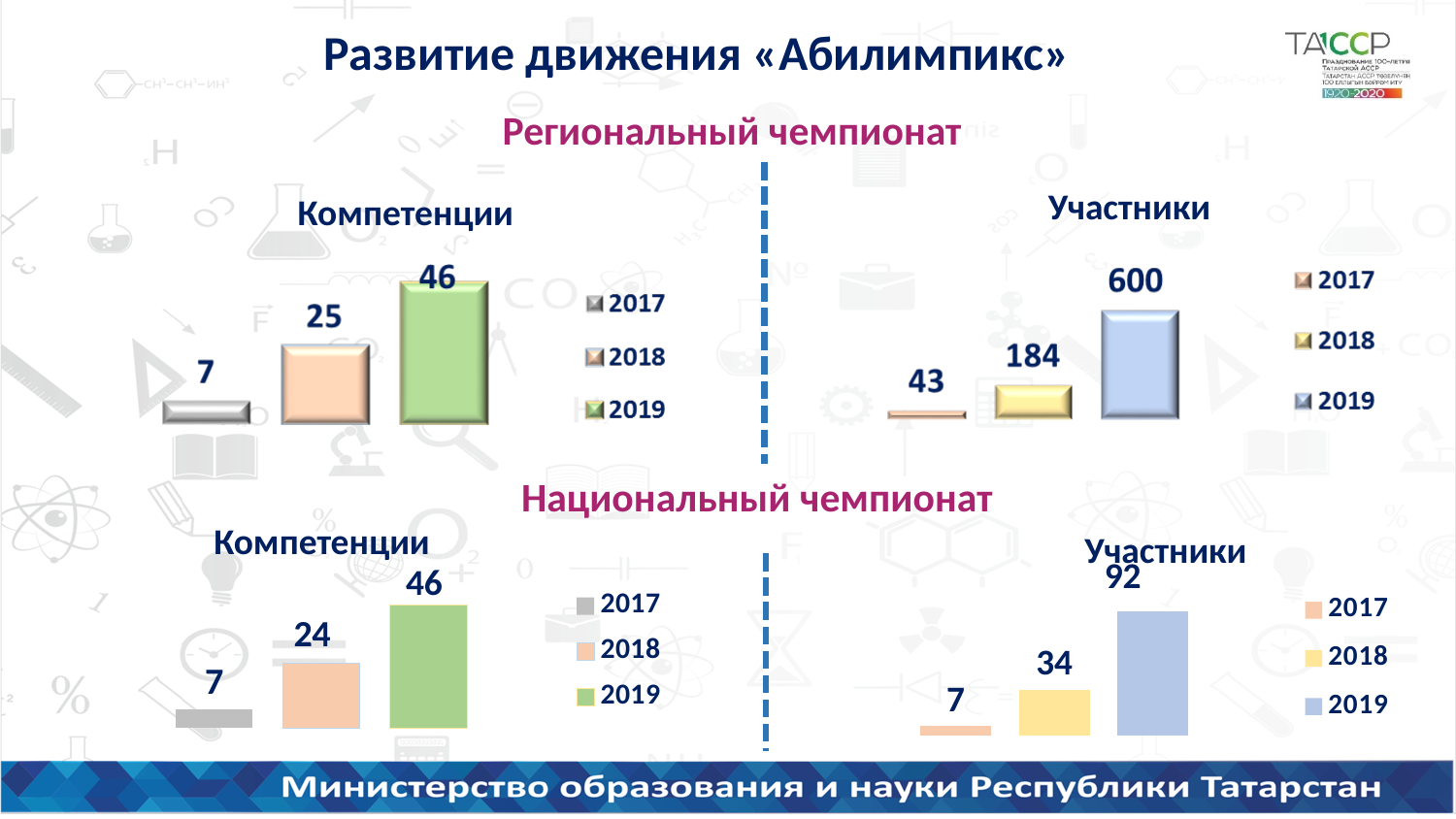
In the 'Компетенции' chart under 'Региональный чемпионат', what is the value for 2019? 46 What type of chart is the 'Участники' chart under 'Региональный чемпионат'? bar chart In the 'Компетенции' chart under 'Региональный чемпионат', which is larger: the value for 2018 or the value for 2017? 2018 In the 'Участники' chart under 'Национальный чемпионат', what is the difference between the 2019 and 2017 values? 85 In the 'Компетенции' chart under 'Национальный чемпионат', what is the value for 2018? 24 In the 'Участники' chart under 'Национальный чемпионат', do the values rise or fall from 2017 to 2019? rise How many bars are in the 'Участники' chart under 'Национальный чемпионат'? 3 In the 'Участники' chart under 'Региональный чемпионат', which year has the highest value? 2019 In the 'Компетенции' chart under 'Национальный чемпионат', which year has the lowest value? 2017 In the 'Участники' chart under 'Региональный чемпионат', what is the value for 2018? 184 In the 'Участники' chart under 'Региональный чемпионат', what is the difference between the 2019 and 2018 values? 416 How many series does the legend list in the 'Компетенции' chart under 'Региональный чемпионат'? 3